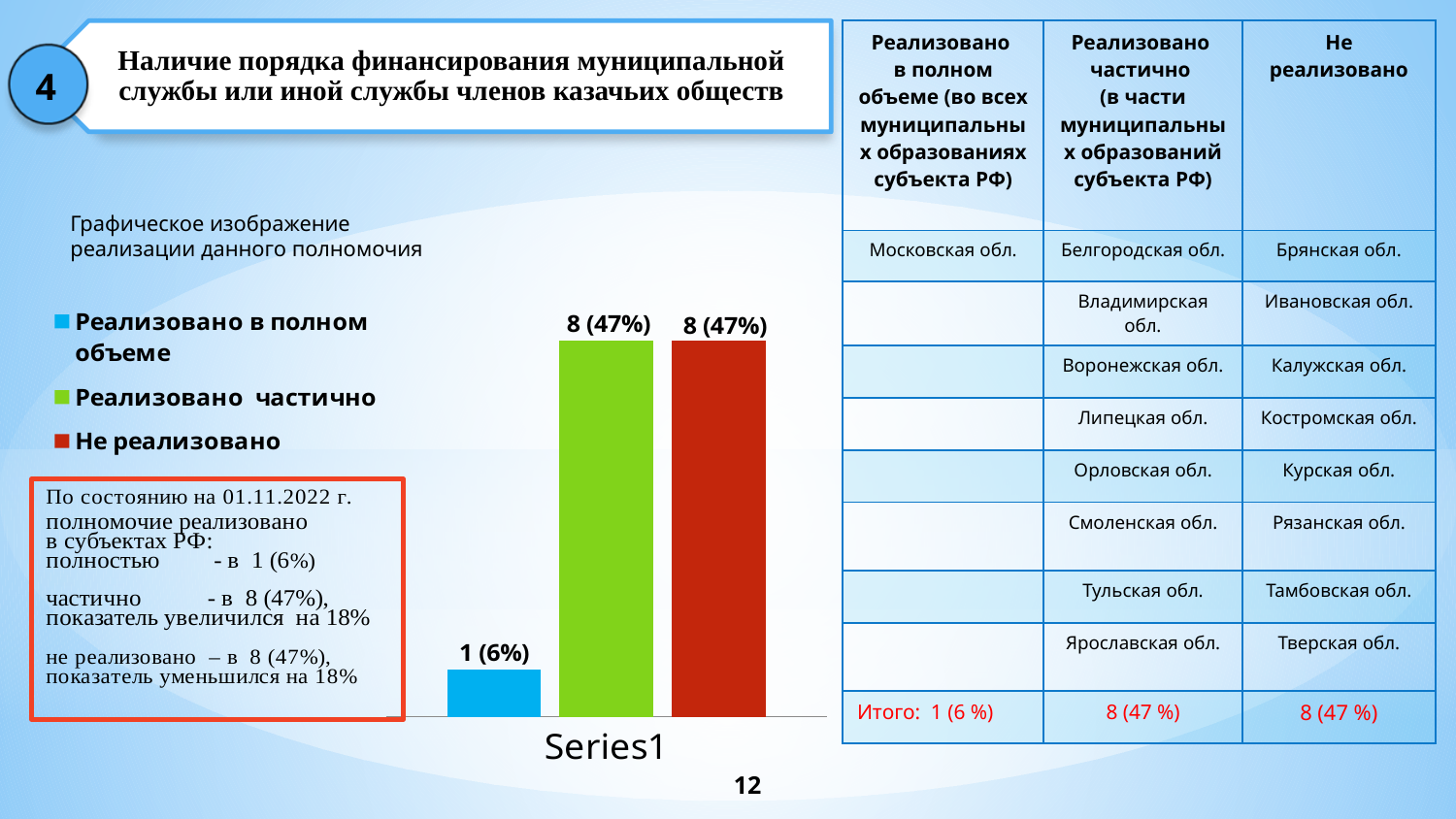
By how many units does the "Не реализовано" bar exceed the "Реализовано в полном объеме" bar? 7 What type of chart is shown on the slide? Bar chart How many entries does the chart legend list? 3 How many bars are plotted in the chart? 3 Which legend category has the lowest bar in the chart? Реализовано в полном объеме What value is shown for the bar labelled "Реализовано в полном объеме"? 1 (6%) What value is shown for the bar labelled "Реализовано частично"? 8 (47%) Do the bars for "Реализовано частично" and "Не реализовано" show the same value? Yes What label appears under the bars on the x axis of the chart? Series1 What colour is the bar for "Не реализовано"? Red Which is larger: the bar for "Реализовано частично" or the bar for "Реализовано в полном объеме"? Реализовано частично What value is shown for the bar labelled "Не реализовано"? 8 (47%)